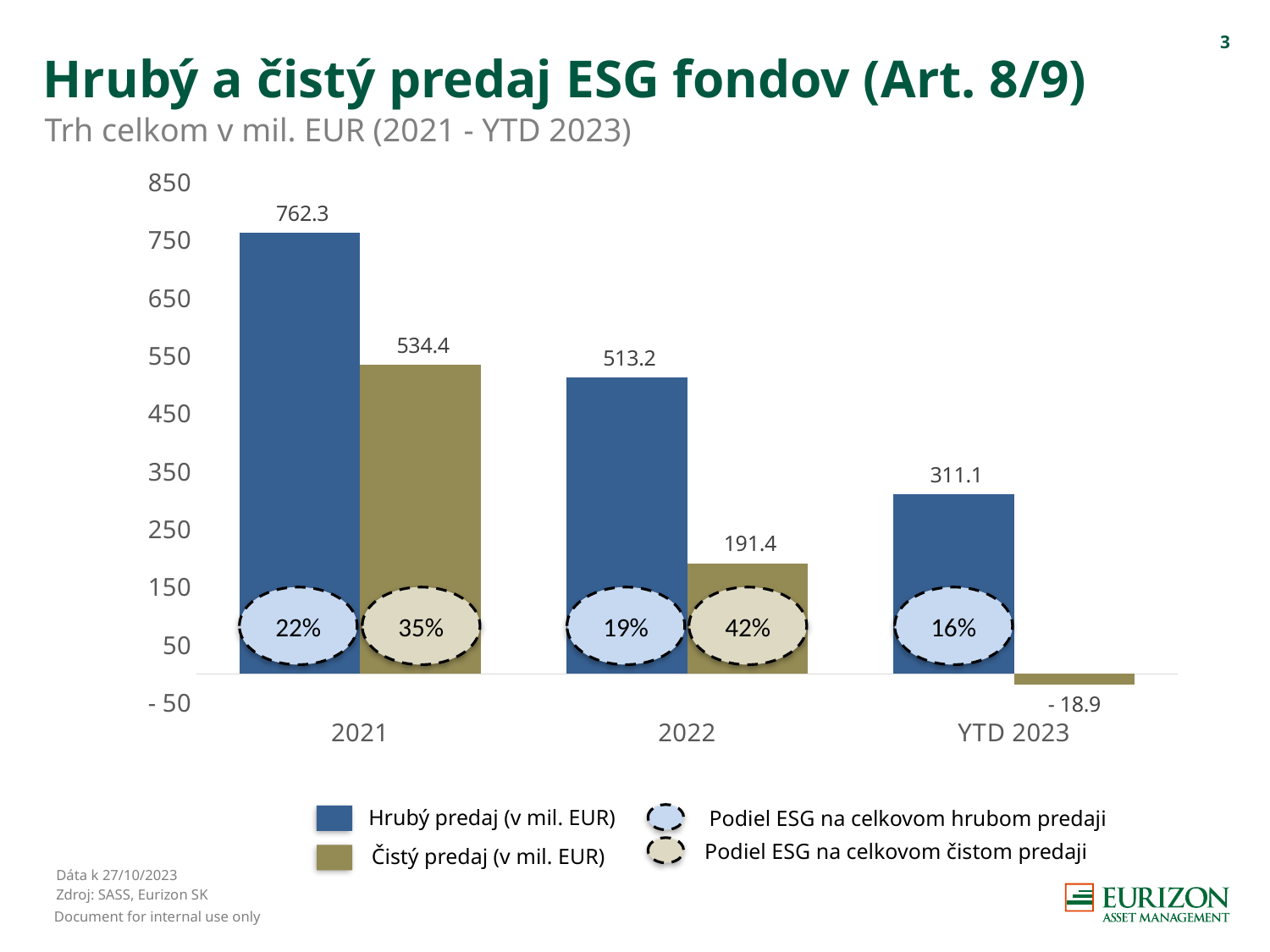
Which year has the lowest Čistý predaj (v mil. EUR)? YTD 2023 How many years (categories) are shown on the x axis? 3 What is the Podiel ESG na celkovom čistom predaji shown for 2022? 42% Which year has the highest Hrubý predaj (v mil. EUR)? 2021 Does Hrubý predaj (v mil. EUR) rise or fall from 2021 to YTD 2023? Fall What is the difference between Hrubý predaj and Čistý predaj in 2021? 227.9 What is the value of Čistý predaj (v mil. EUR) for YTD 2023? - 18.9 What kind of chart is shown on the slide? Bar chart Which is larger: Hrubý predaj in 2022 or Čistý predaj in 2021? Čistý predaj in 2021 What is the value of Hrubý predaj (v mil. EUR) for 2021? 762.3 What is the value of Čistý predaj (v mil. EUR) for 2022? 191.4 How many bar series does the legend list? 2